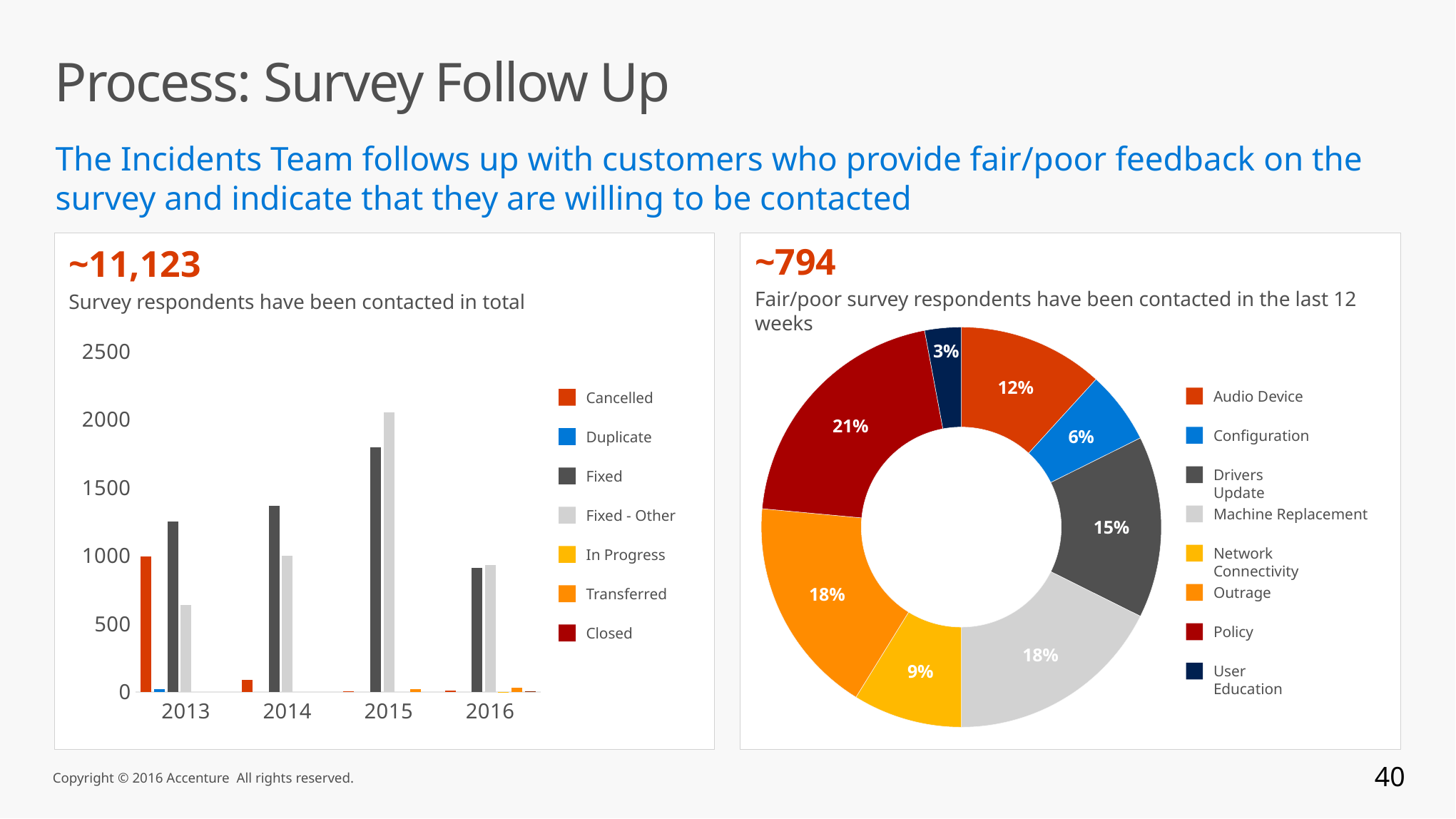
In the chart on the right, what percentage is shown for Drivers Update? 15% In the chart on the right, which is larger: Configuration or Network Connectivity? Network Connectivity How many categories does the legend of the chart on the right list? 8 How many series does the legend of the chart on the left list? 7 In the chart on the right, what is the difference in percentage points between Policy and Audio Device? 9% In the chart on the right, what share of the donut is Policy? 21% In the chart on the right, which category has the smallest share? User Education In the chart on the right, which category has the largest share? Policy What kind of chart is the chart on the left? Bar chart What kind of chart is the chart on the right? Donut (pie) chart In the chart on the left, is the value for Fixed - Other in 2015 greater or less than 2000? greater In the chart on the left, is the value for Fixed in 2014 greater or less than 1500? less